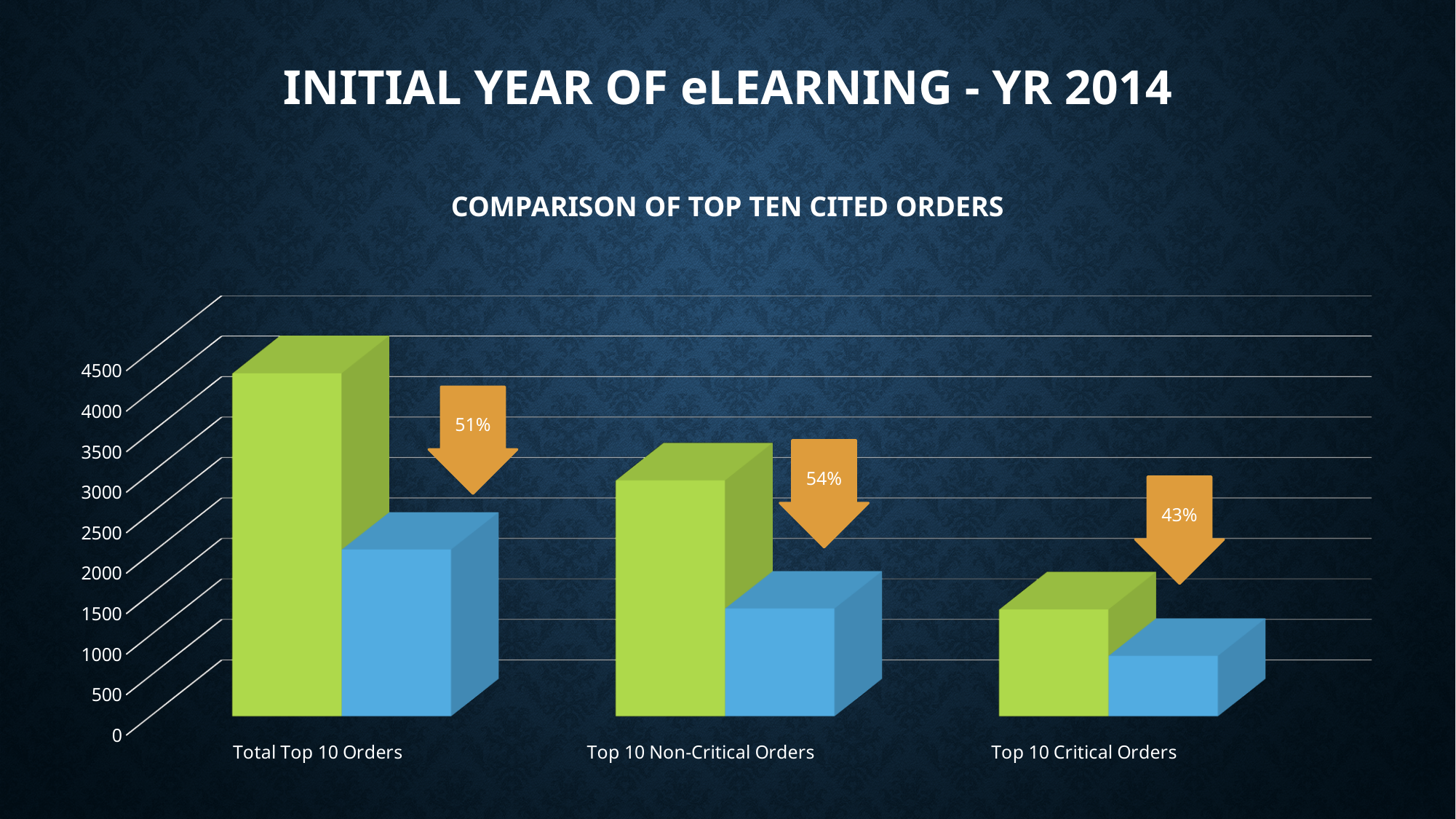
Is the green bar for Total Top 10 Orders greater or less than 4000? greater Is the blue bar for Top 10 Non-Critical Orders greater or less than 1000? greater For Top 10 Critical Orders, which bar is taller, the green one or the blue one? green Is the blue bar for Top 10 Critical Orders greater or less than 1000? less Which category has the shortest blue bar? Top 10 Critical Orders What is the title of the chart? Comparison of Top Ten Cited Orders What kind of chart is shown on the slide? bar chart What percentage is printed in the arrow above Top 10 Critical Orders? 43% Which category has the tallest green bar? Total Top 10 Orders Do the green bars rise or fall moving from left to right across the categories? fall How many categories are shown on the x axis of the chart? 3